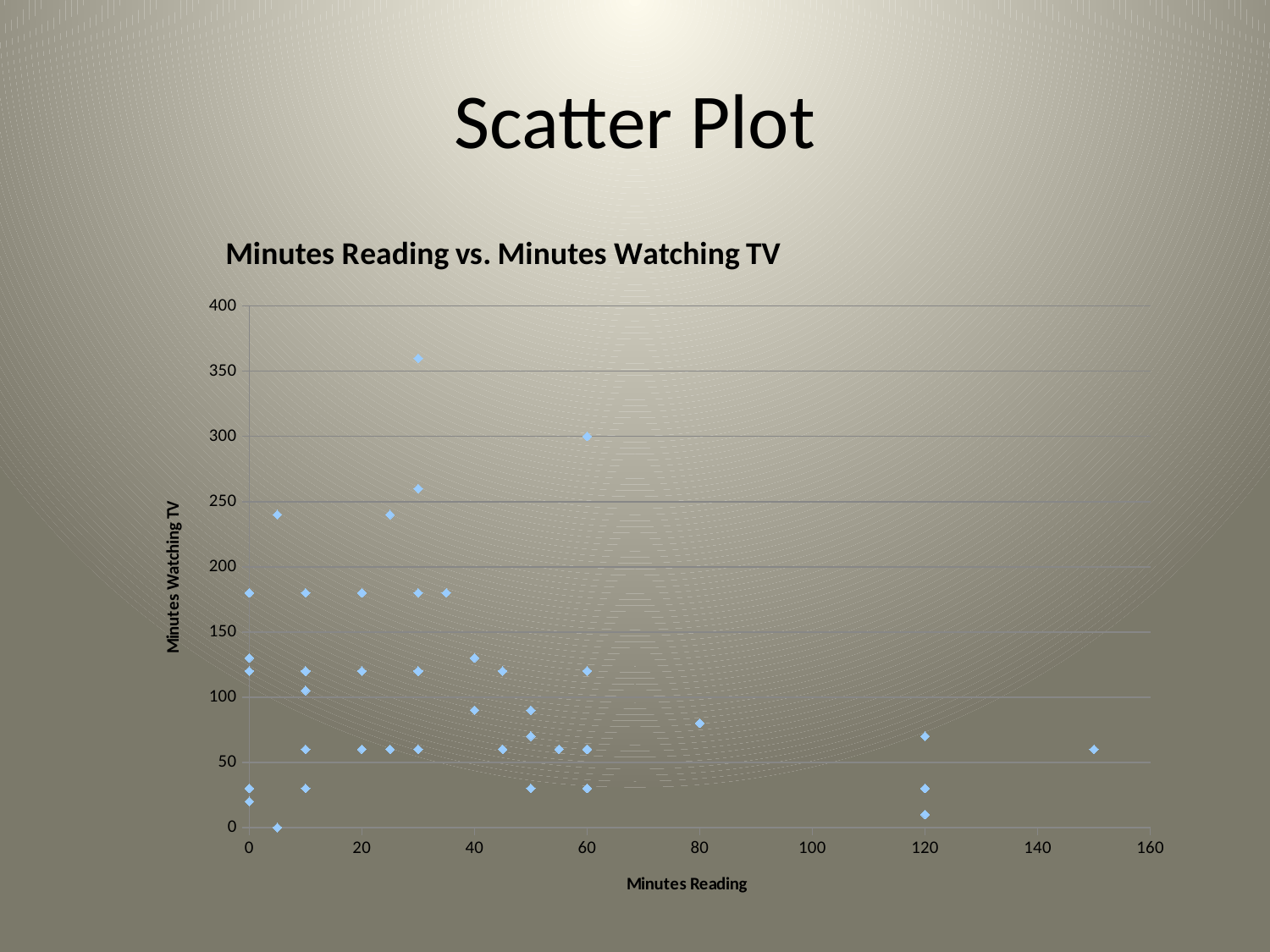
Is the Minutes Watching TV value for the point at Minutes Reading = 150 greater or less than 100? less What is the maximum value shown on the Minutes Reading axis? 160 Which has the higher Minutes Watching TV value: the point at Minutes Reading = 80 or the point at Minutes Reading = 150? Minutes Reading = 80 Are all the points at Minutes Reading = 120 below 100 Minutes Watching TV? Yes Which is higher: the topmost point at Minutes Reading = 30 or the topmost point at Minutes Reading = 60? Minutes Reading = 30 Is the Minutes Watching TV value for the point at Minutes Reading = 80 greater or less than 50? greater What is the highest Minutes Watching TV value plotted at Minutes Reading = 60? 300 What kind of chart is shown on the slide? Scatter plot What is the title of the chart? Minutes Reading vs. Minutes Watching TV What is the label of the vertical axis? Minutes Watching TV